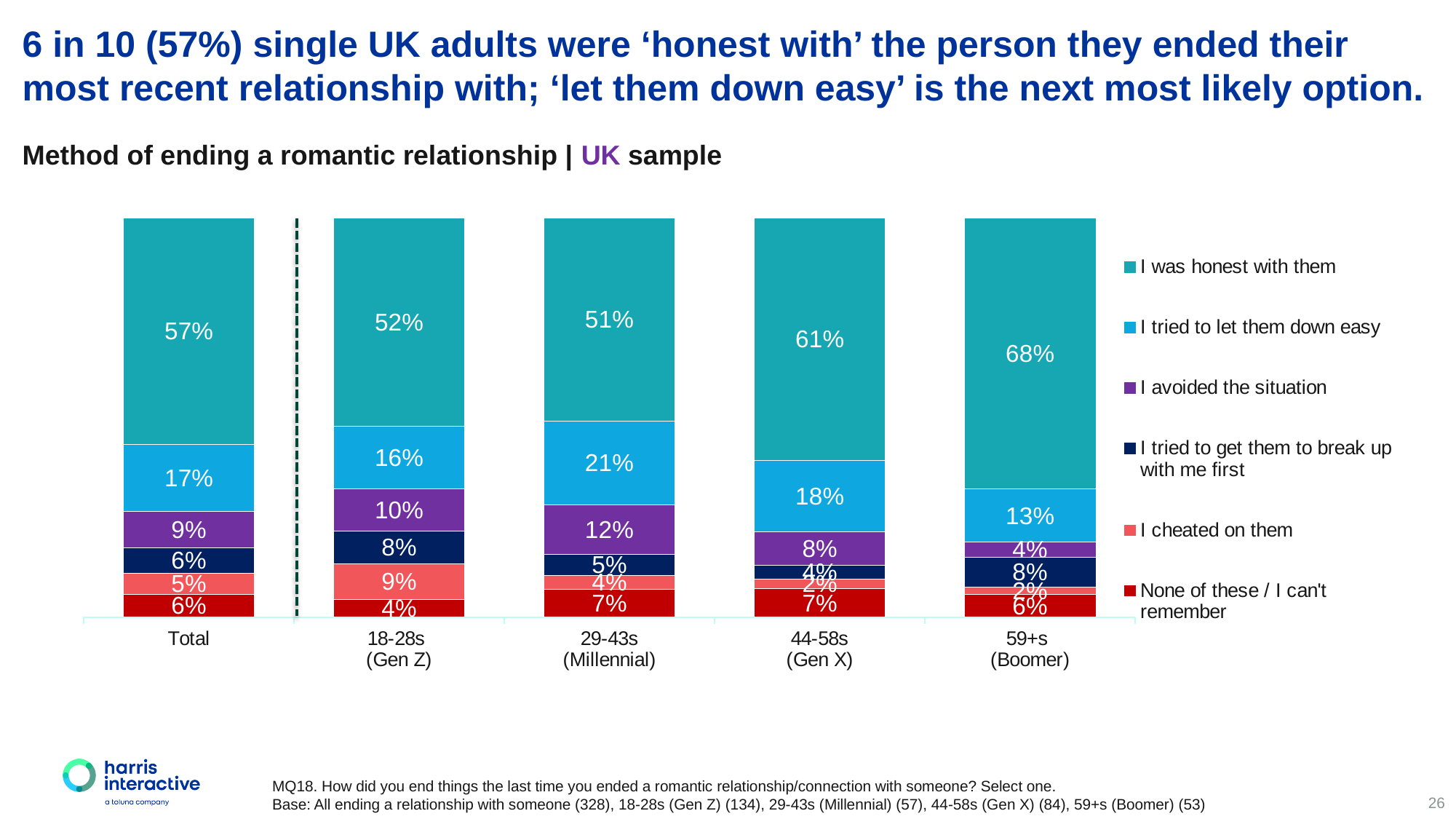
What is the total of the segments in the 29-43s (Millennial) bar? 100% What kind of chart is shown on the slide? Stacked bar chart What percentage of 18-28s (Gen Z) said 'I cheated on them'? 9% What is the value for 'I tried to get them to break up with me first' in the Total bar? 6% Which group has the lowest share for 'I was honest with them'? 29-43s (Millennial) What percentage of 59+s (Boomer) respondents said 'I was honest with them'? 68% How many series does the legend list? 6 How many percentage points higher is 'I was honest with them' for 59+s (Boomer) than for 18-28s (Gen Z)? 16 percentage points Which group has the highest share for 'I was honest with them'? 59+s (Boomer) What is the value for 'I tried to let them down easy' among 29-43s (Millennial)? 21% Which group has a larger share for 'I avoided the situation': 18-28s (Gen Z) or 44-58s (Gen X)? 18-28s (Gen Z) How many groups (bars) are shown on the x axis? 5